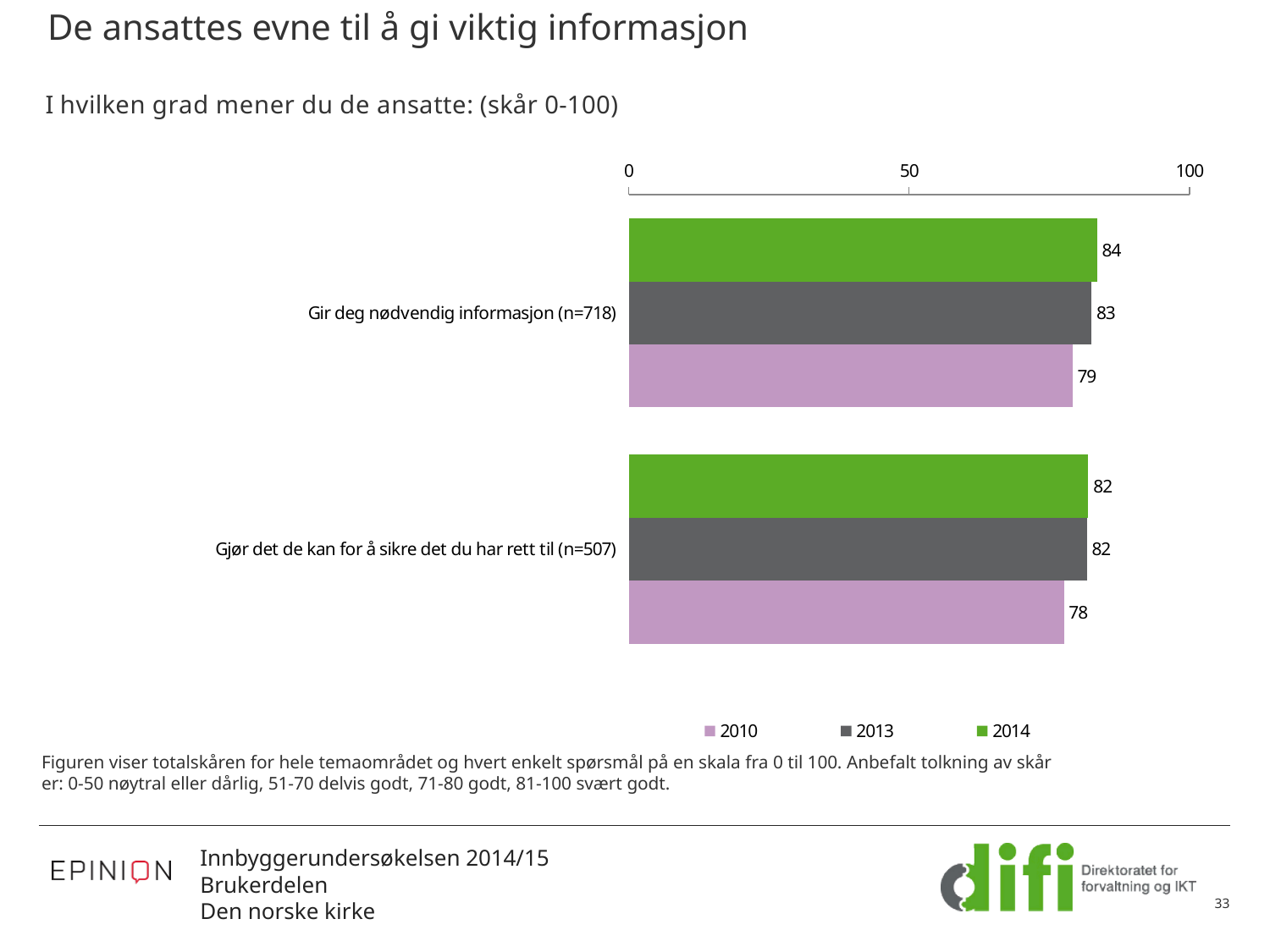
Which is larger: the 2014 value for "Gir deg nødvendig informasjon (n=718)" or the 2014 value for "Gjør det de kan for å sikre det du har rett til (n=507)"? Gir deg nødvendig informasjon (n=718) What is the 2014 value for "Gir deg nødvendig informasjon (n=718)"? 84 Which series has the lowest value for "Gir deg nødvendig informasjon (n=718)"? 2010 What is the 2013 value for "Gir deg nødvendig informasjon (n=718)"? 83 What is the difference between the 2014 and 2010 values for "Gir deg nødvendig informasjon (n=718)"? 5 What is the 2010 value for "Gjør det de kan for å sikre det du har rett til (n=507)"? 78 How many series does the legend list? 3 How many categories (questions) are shown in the chart? 2 What is the 2013 value for "Gjør det de kan for å sikre det du har rett til (n=507)"? 82 Is the 2010 value for "Gjør det de kan for å sikre det du har rett til (n=507)" greater or less than 50? greater What kind of chart is shown on the slide? bar chart What is the difference between the 2013 and 2010 values for "Gjør det de kan for å sikre det du har rett til (n=507)"? 4